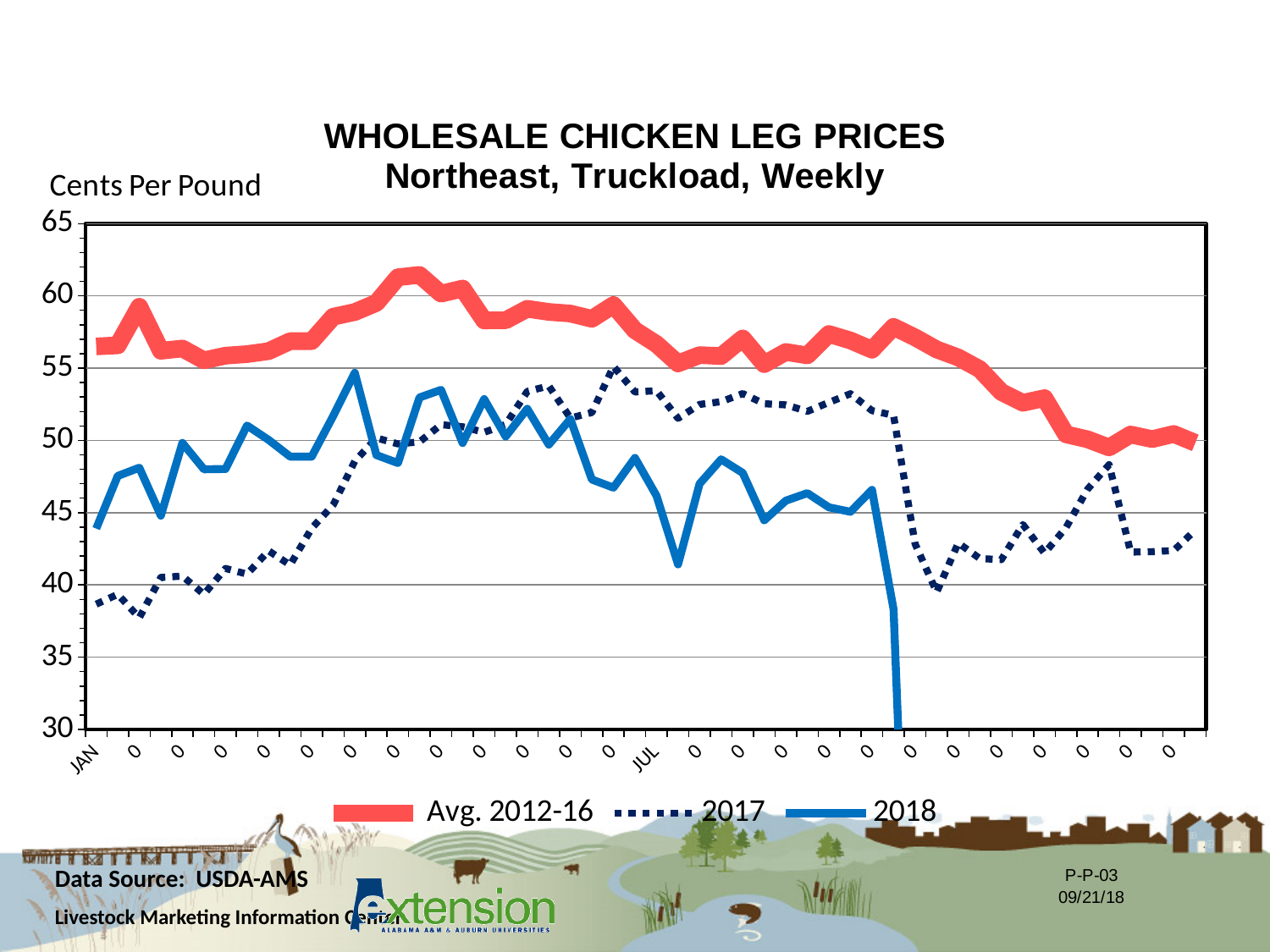
Is the value for 2018 at JUL greater or less than 50? less What kind of chart is shown on the slide? line chart How many series does the legend list? 3 Is the value for 2017 at JAN greater or less than 40? less At JAN, which is higher: the Avg. 2012-16 series or the 2017 series? Avg. 2012-16 Is the value for Avg. 2012-16 at JAN greater or less than 55? greater Which series are listed in the legend? Avg. 2012-16, 2017, 2018 Does the 2017 series generally rise or fall from JAN to JUL? rise What unit is shown on the vertical axis label? Cents Per Pound Which series has the highest value at JAN? Avg. 2012-16